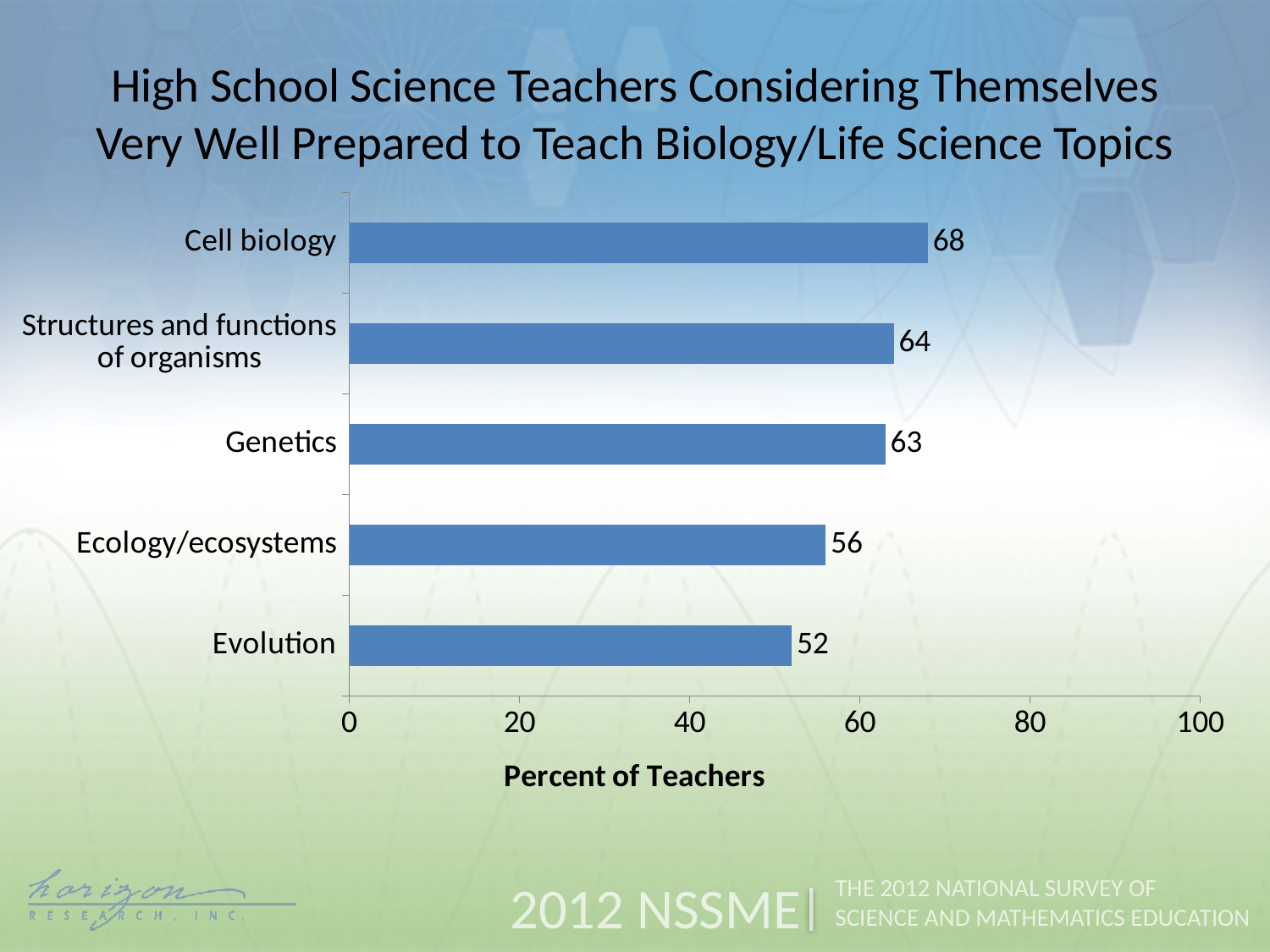
What is the difference between the values for Cell biology and Evolution? 16 How many topics are shown in the chart? 5 What percent of teachers consider themselves very well prepared to teach Cell biology? 68 Which is larger, the value for Genetics or the value for Ecology/ecosystems? Genetics Is the value for Evolution greater or less than 60? less What is the value for Ecology/ecosystems? 56 Which topic has the highest percent of teachers? Cell biology What is the value for Structures and functions of organisms? 64 What is the value for Evolution? 52 Which topic has the lowest percent of teachers? Evolution What is the difference between the values for Genetics and Ecology/ecosystems? 7 What kind of chart is shown on the slide? bar chart